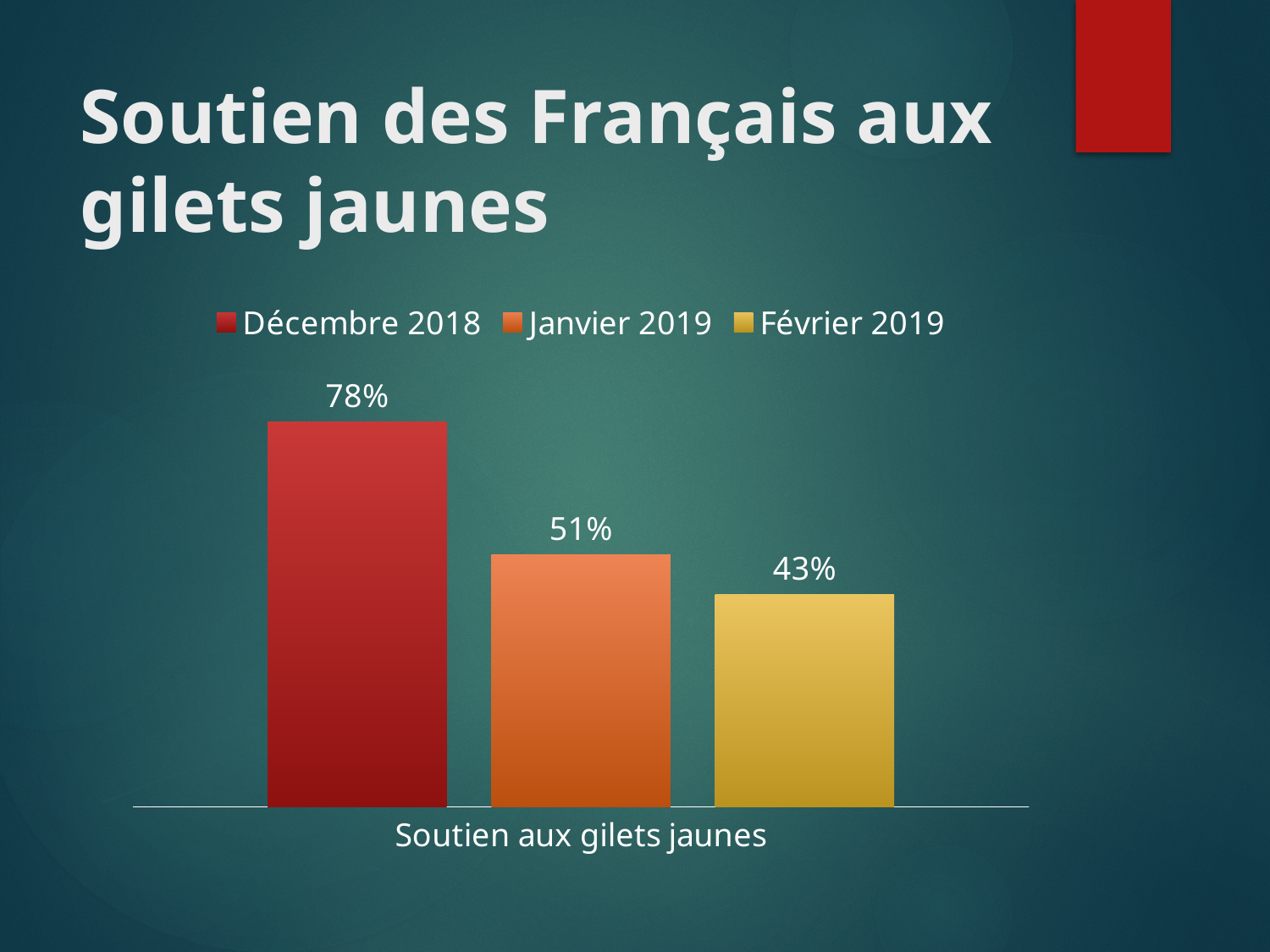
What is the value for Février 2019? 43% What is the difference between the values for Janvier 2019 and Février 2019? 8% Do the values rise or fall from Décembre 2018 to Février 2019? Fall Which series has the highest value? Décembre 2018 What is the category label shown on the x axis? Soutien aux gilets jaunes Which series has the lowest value? Février 2019 Which is larger, the value for Janvier 2019 or the value for Février 2019? Janvier 2019 What is the value for Janvier 2019? 51% What is the difference between the values for Décembre 2018 and Janvier 2019? 27% How many series does the legend list? 3 What is the value for Décembre 2018? 78% What kind of chart is shown on the slide? Bar chart